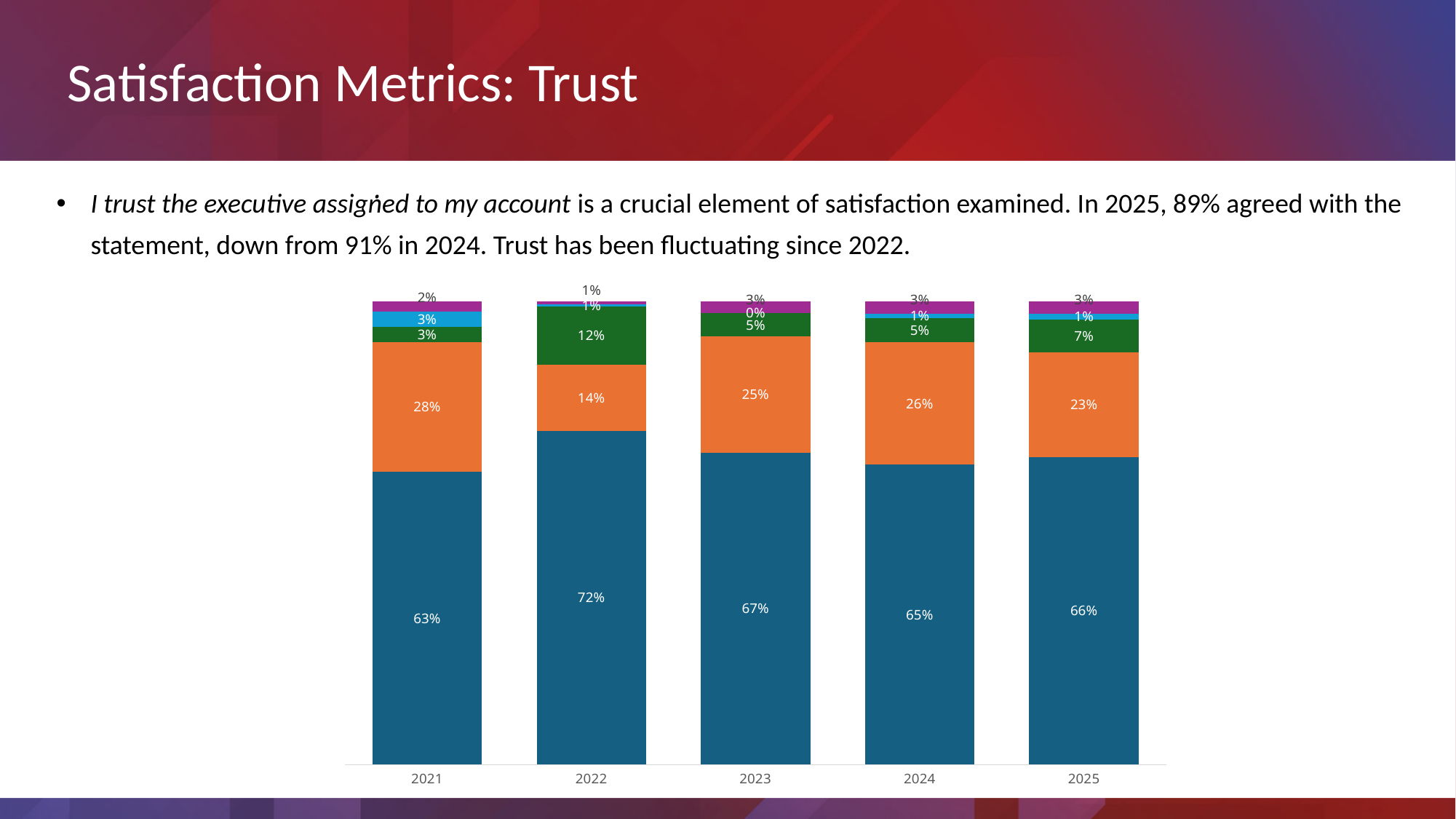
Which year has the highest value for the bottom (dark blue) segment? 2022 What is the value of the bottom (dark blue) segment for 2022? 72% What is the combined total of the bottom (dark blue) and orange segments for 2024? 91% Which year has the lowest value for the orange segment? 2022 What is the value of the green segment for 2022? 12% What is the difference between the bottom (dark blue) segment values for 2022 and 2021? 9% Which year has the lowest value for the bottom (dark blue) segment? 2021 What type of chart is shown on the slide? Stacked bar chart How many years are shown along the x axis of the chart? 5 What is the value of the orange segment for 2021? 28% What is the value of the bottom (dark blue) segment for 2025? 66% Is the orange segment larger for 2024 or for 2025? 2024